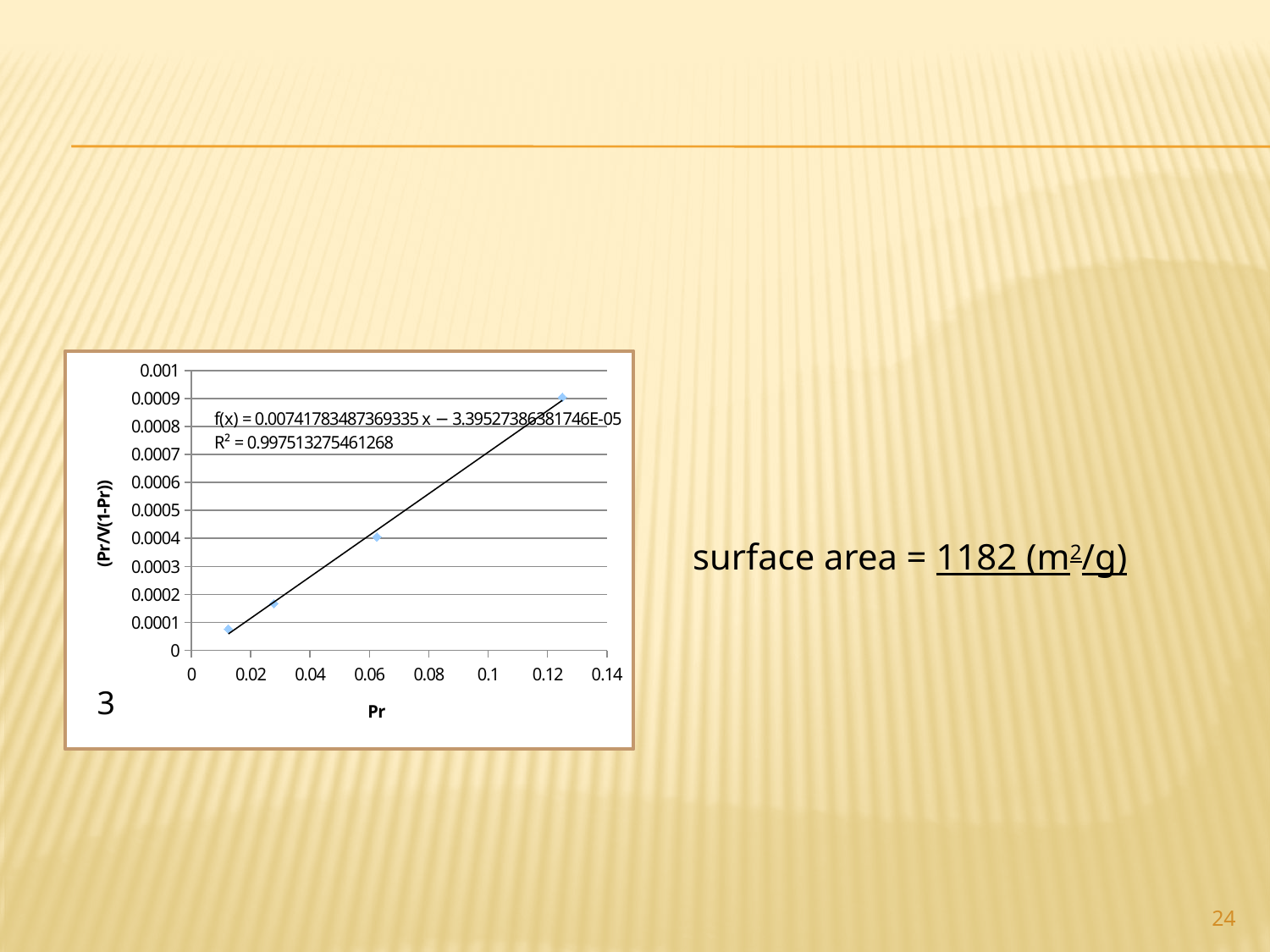
What kind of chart is shown on the slide? scatter chart Do the plotted values rise or fall as Pr increases along the x axis? rise What is the title of the x axis of the chart? Pr How many data points are plotted on the chart? 4 Which data point has the lowest y value on the chart? the leftmost point (near Pr = 0.01) What is the highest tick value shown on the x axis? 0.14 Is the value of the rightmost data point (near Pr = 0.12) greater or less than 0.0005? greater Is the value of the data point near Pr = 0.03 greater or less than 0.0003? less Which data point has the higher y value: the one near Pr = 0.06 or the one near Pr = 0.12? the one near Pr = 0.12 What is the highest tick value shown on the y axis? 0.001 What is the R² value shown on the chart? 0.997513275461268 Is the value of the leftmost data point (near Pr = 0.01) greater or less than 0.0002? less